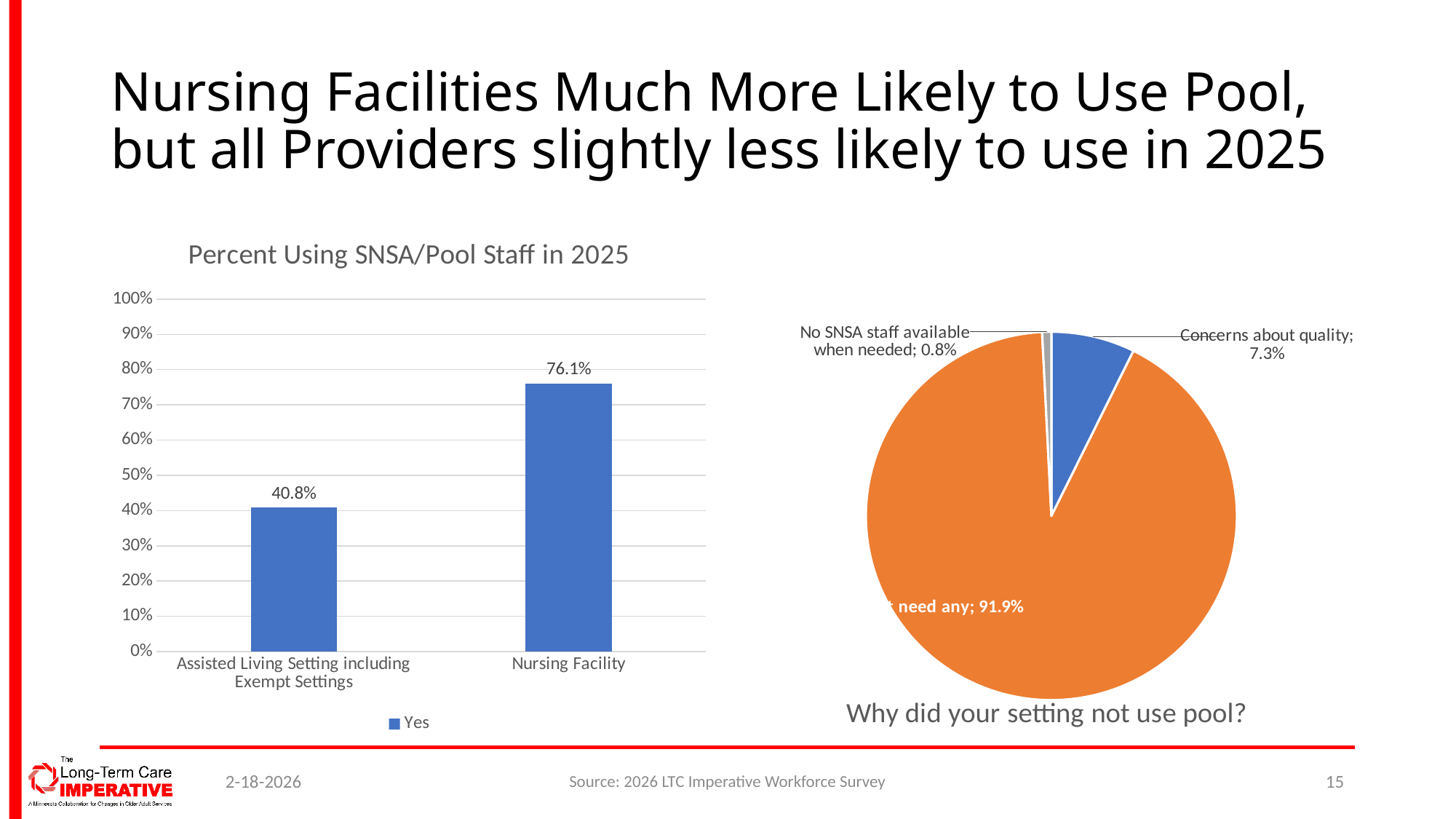
In the bar chart 'Percent Using SNSA/Pool Staff in 2025', how many categories are shown on the x axis? 2 In the bar chart 'Percent Using SNSA/Pool Staff in 2025', what is the value for Assisted Living Setting including Exempt Settings? 40.8% In the pie chart 'Why did your setting not use pool?', what share is labelled for 'No SNSA staff available when needed'? 0.8% In the pie chart 'Why did your setting not use pool?', which is larger: 'Concerns about quality' or 'No SNSA staff available when needed'? Concerns about quality In the pie chart 'Why did your setting not use pool?', what share is labelled for 'Concerns about quality'? 7.3% What kind of chart is 'Percent Using SNSA/Pool Staff in 2025'? Bar chart In the bar chart 'Percent Using SNSA/Pool Staff in 2025', what is the value for Nursing Facility? 76.1% In the bar chart 'Percent Using SNSA/Pool Staff in 2025', what is the difference in percentage points between Nursing Facility and Assisted Living Setting including Exempt Settings? 35.3 percentage points What kind of chart is 'Why did your setting not use pool?'? Pie chart In the pie chart 'Why did your setting not use pool?', what share is labelled on the largest (orange) slice? 91.9% In the bar chart 'Percent Using SNSA/Pool Staff in 2025', which category has the highest value? Nursing Facility In the bar chart 'Percent Using SNSA/Pool Staff in 2025', what series does the legend list? Yes